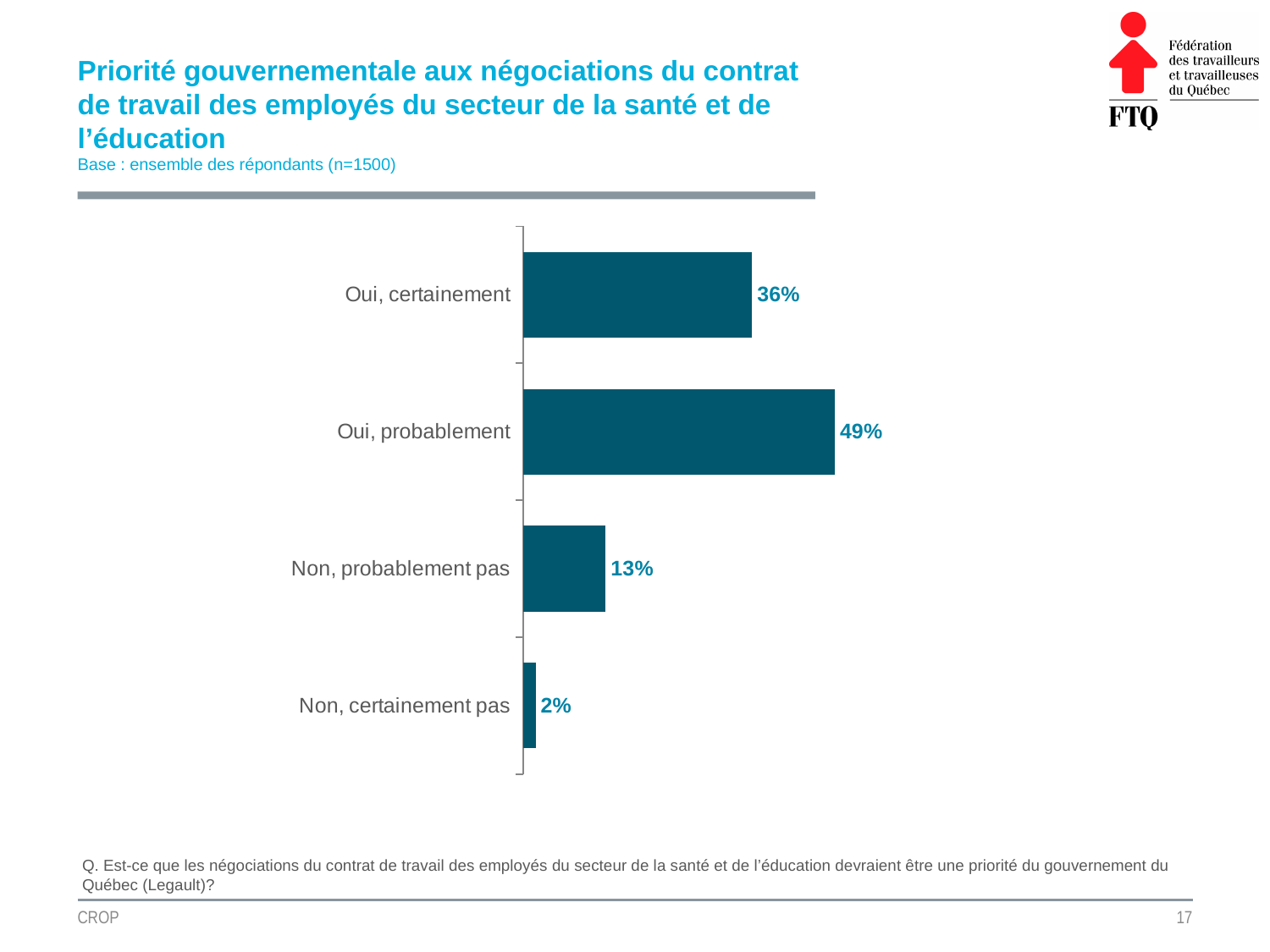
Which is larger, the value for "Oui, certainement" or the value for "Non, probablement pas"? Oui, certainement What kind of chart is shown on the slide? Bar chart What is the value for "Oui, certainement"? 36% What is the difference between the values for "Non, probablement pas" and "Non, certainement pas"? 11% Which category has the lowest value? Non, certainement pas Which category has the highest value? Oui, probablement What is the difference between the values for "Oui, probablement" and "Oui, certainement"? 13% What is the value for "Non, probablement pas"? 13% What is the value for "Oui, probablement"? 49% What is the base (number of respondents) stated for the chart? n=1500 How many categories are shown in the chart? 4 What is the value for "Non, certainement pas"? 2%